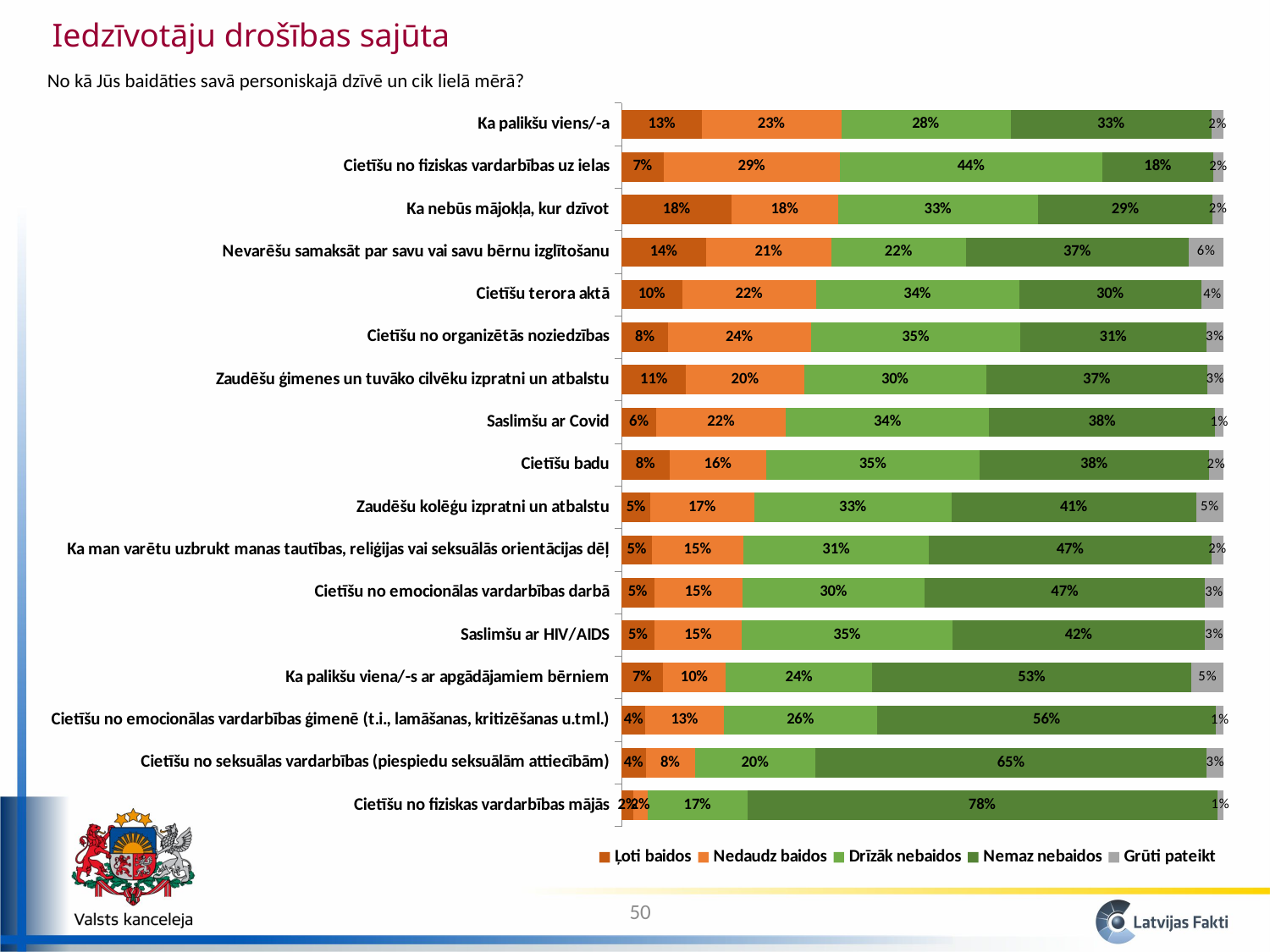
Which category has the highest "Nemaz nebaidos" value? Cietīšu no fiziskas vardarbības mājās What is the "Drīzāk nebaidos" value for "Cietīšu no fiziskas vardarbības uz ielas"? 44% How many series does the legend list? 5 What percentage of respondents answered "Nemaz nebaidos" for "Cietīšu no fiziskas vardarbības mājās"? 78% What is the "Ļoti baidos" value for "Ka nebūs mājokļa, kur dzīvot"? 18% What is the combined share of "Ļoti baidos" and "Nedaudz baidos" for "Ka nebūs mājokļa, kur dzīvot"? 36% Which has the larger "Nedaudz baidos" value: "Cietīšu no fiziskas vardarbības uz ielas" or "Ka palikšu viens/-a"? Cietīšu no fiziskas vardarbības uz ielas How many percentage points higher is the "Nemaz nebaidos" value for "Cietīšu no seksuālas vardarbības (piespiedu seksuālām attiecībām)" than for "Ka palikšu viens/-a"? 32 percentage points Which category has the highest "Ļoti baidos" value? Ka nebūs mājokļa, kur dzīvot What is the "Grūti pateikt" value for "Nevarēšu samaksāt par savu vai savu bērnu izglītošanu"? 6% How many categories (fears) are shown in the chart? 17 What kind of chart is shown on the slide? Stacked bar chart